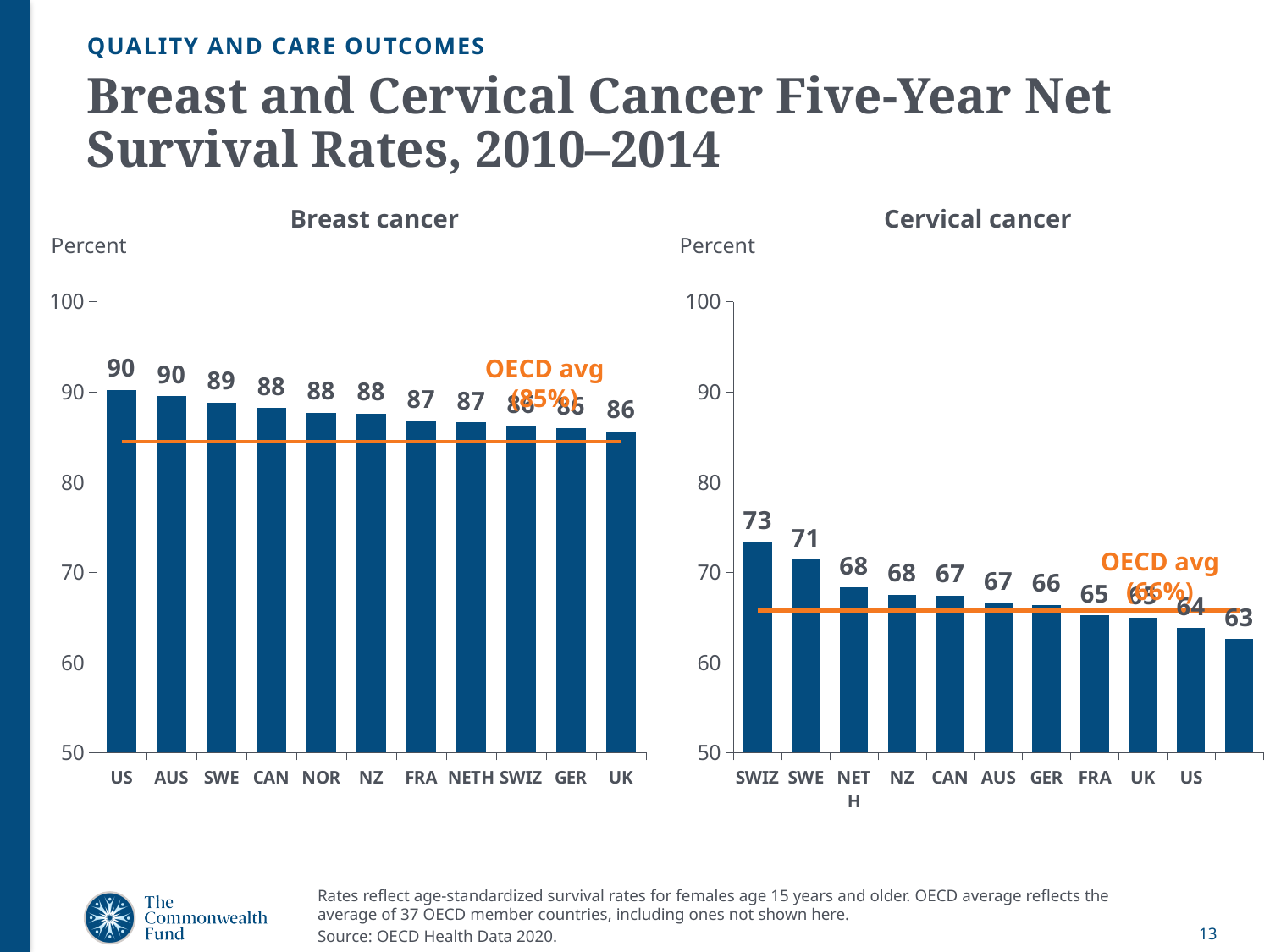
On the Breast cancer chart, what is the five-year net survival rate for the US? 90 On the Breast cancer chart, what OECD average is shown? 85% On the Cervical cancer chart, what is the value for SWE? 71 On the Cervical cancer chart, what is the difference between the values for SWIZ and FRA? 8 On the Breast cancer chart, how many countries are shown on the x axis? 11 On the Cervical cancer chart, is the value for SWIZ greater or less than 70? greater On the Breast cancer chart, what is the difference between the values for the US and the UK? 4 On the Cervical cancer chart, what is the value for GER? 66 On the Cervical cancer chart, which country has the highest survival rate? SWIZ On the Breast cancer chart, what is the value for FRA? 87 On the Breast cancer chart, what is the value for the UK? 86 What kind of chart is the Breast cancer chart? Bar chart